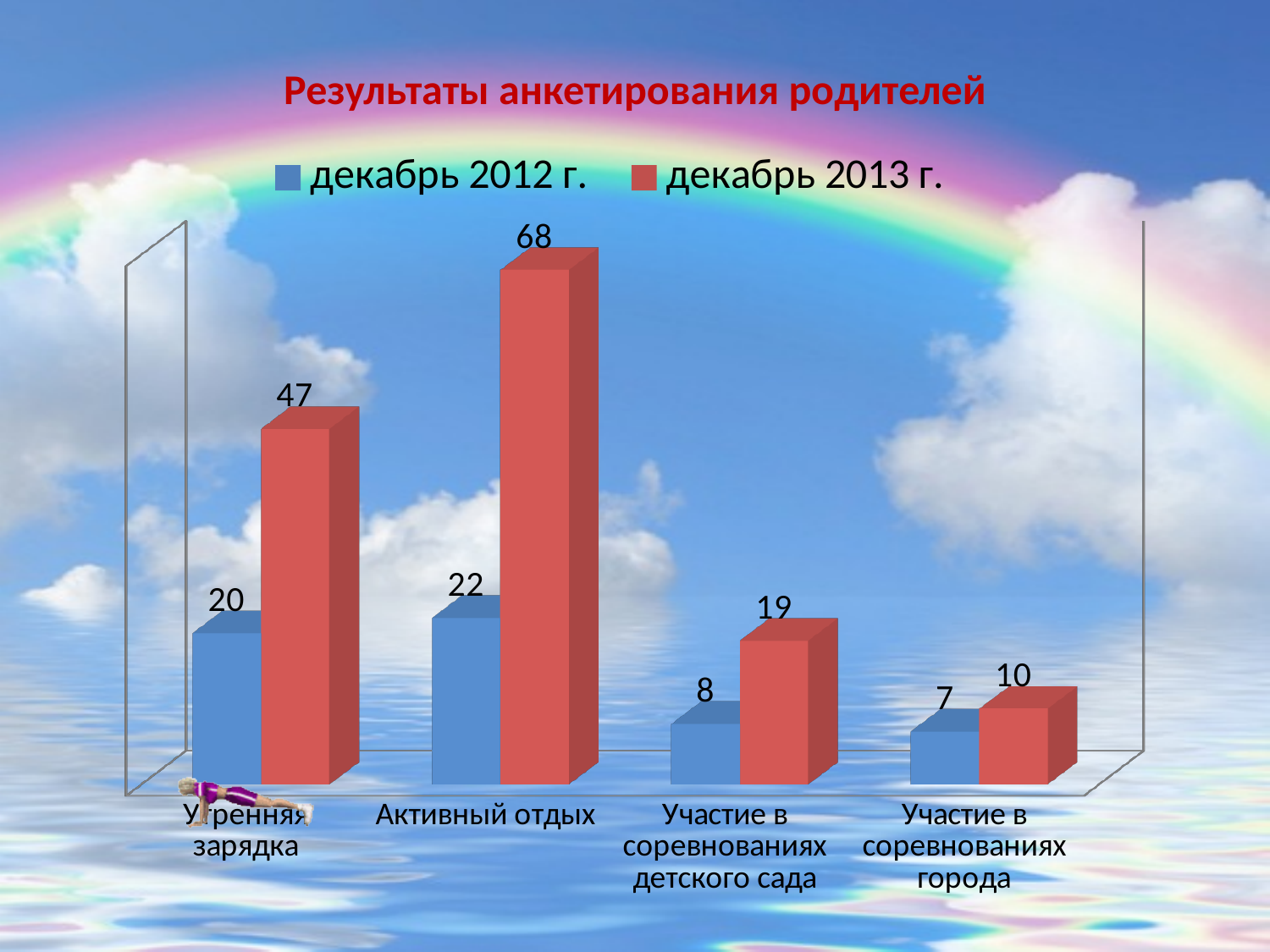
Which is larger for «Участие в соревнованиях детского сада»: the «декабрь 2012 г.» value or the «декабрь 2013 г.» value? декабрь 2013 г. What is the difference between the «декабрь 2013 г.» and «декабрь 2012 г.» values for «Утренняя зарядка»? 27 What kind of chart is shown on the slide? Bar chart What is the value for «Активный отдых» in the «декабрь 2013 г.» series? 68 What is the difference between the «декабрь 2013 г.» and «декабрь 2012 г.» values for «Активный отдых»? 46 What is the value for «Утренняя зарядка» in the «декабрь 2012 г.» series? 20 How many categories are shown on the x axis? 4 What is the title of the chart? Результаты анкетирования родителей How many series does the legend list? 2 What is the value for «Участие в соревнованиях города» in the «декабрь 2013 г.» series? 10 Which category has the lowest value in the «декабрь 2012 г.» series? Участие в соревнованиях города Which category has the highest value in the «декабрь 2013 г.» series? Активный отдых